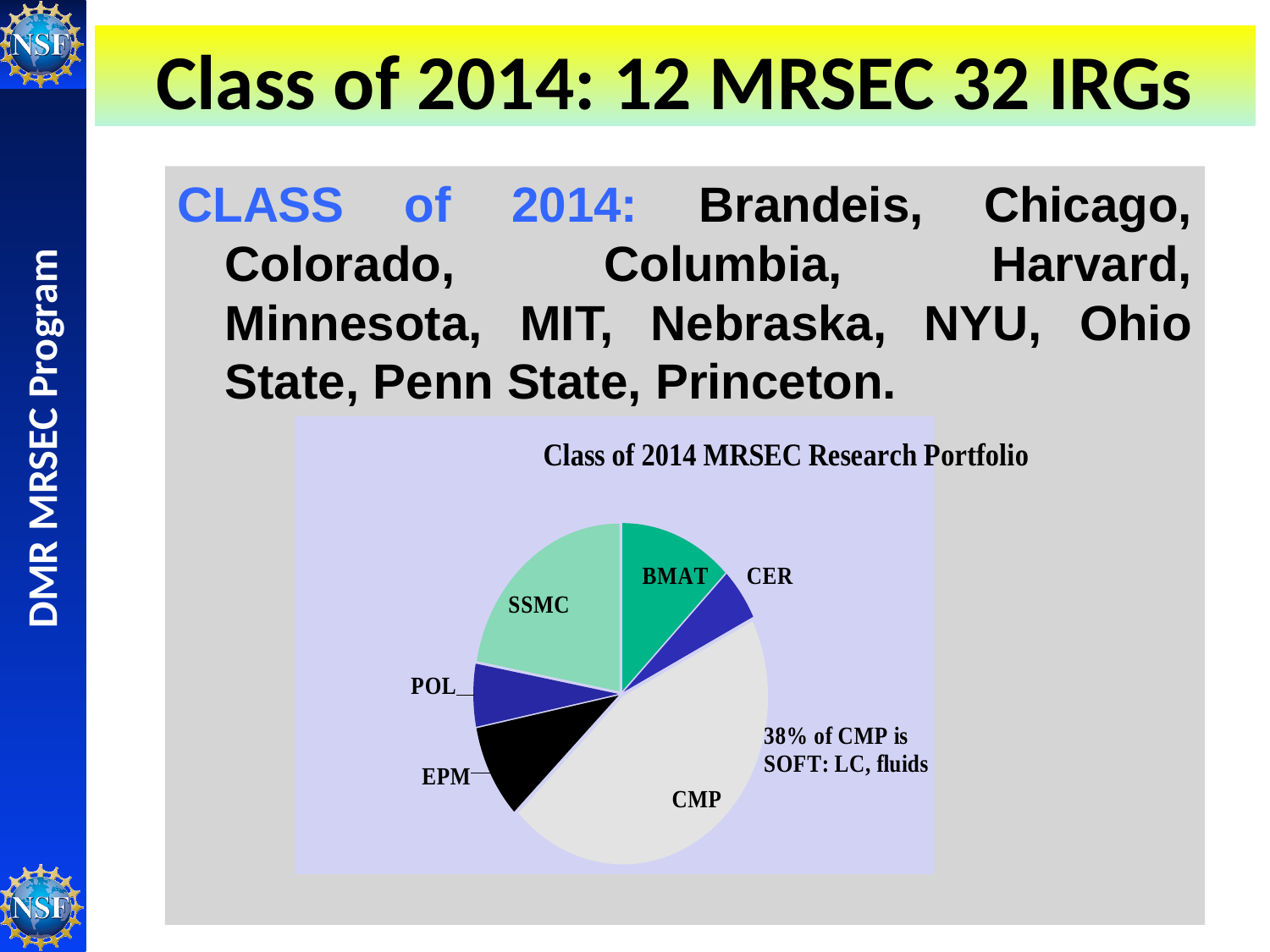
What is the title of the chart? Class of 2014 MRSEC Research Portfolio Which slice is larger, CMP or SSMC? CMP How many slices does the pie chart have? 6 Which slice is larger, SSMC or BMAT? SSMC According to the annotation on the chart, what percentage of CMP is SOFT? 38% Which slice of the pie chart is the largest? CMP Which slice is larger, SSMC or EPM? SSMC What kind of chart is shown on the slide? pie chart